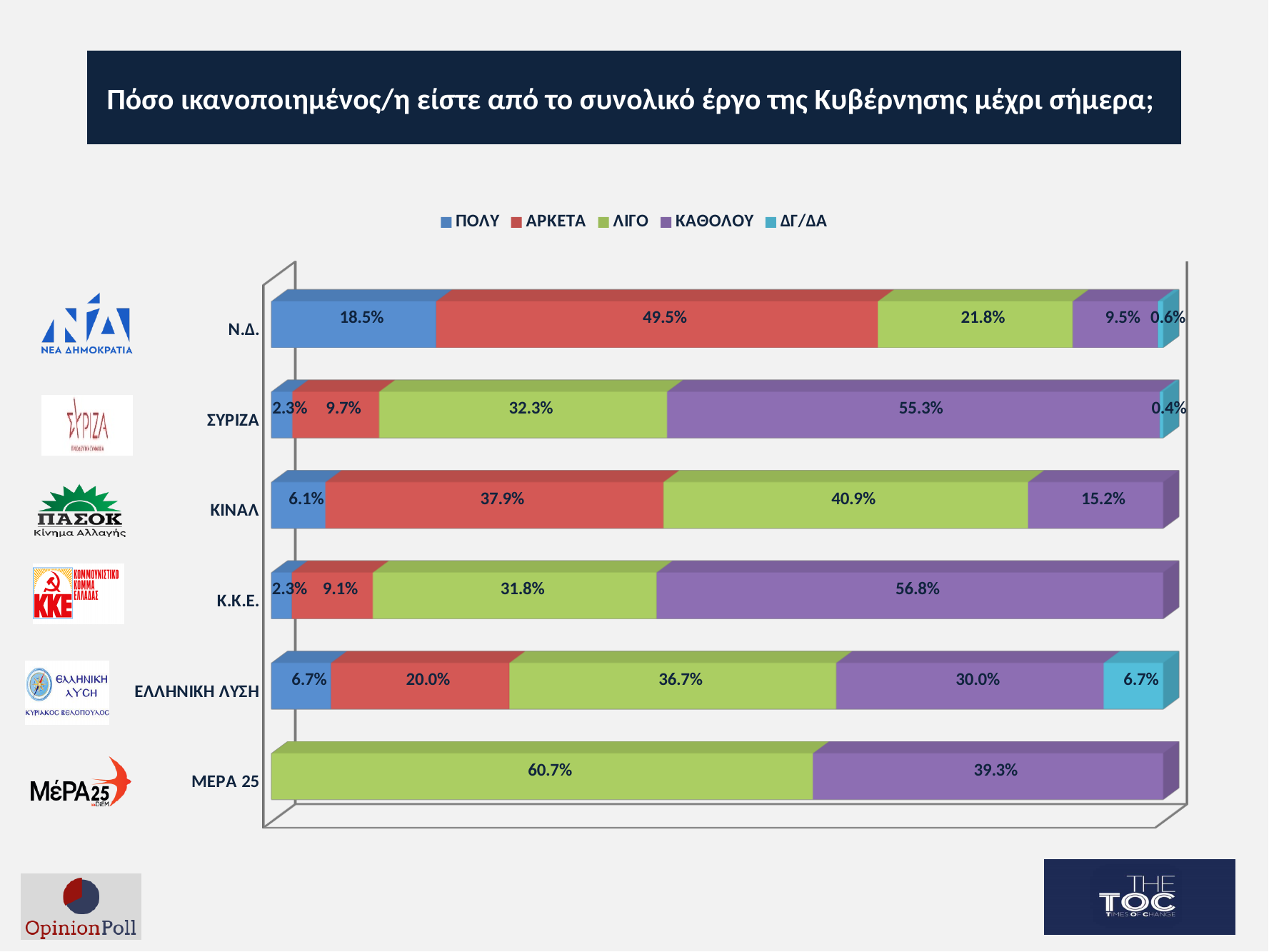
Which party has the highest ΚΑΘΟΛΟΥ value? Κ.Κ.Ε. What is the ΛΙΓΟ value for ΜΕΡΑ 25? 60.7% What is the total of the ΠΟΛΥ and ΑΡΚΕΤΑ values for Ν.Δ.? 68.0% Which is larger: the ΑΡΚΕΤΑ value for ΚΙΝΑΛ or the ΑΡΚΕΤΑ value for ΕΛΛΗΝΙΚΗ ΛΥΣΗ? ΚΙΝΑΛ How many parties (categories) are shown in the chart? 6 What is the ΑΡΚΕΤΑ value for Ν.Δ.? 49.5% What kind of chart is shown on the slide? Stacked bar chart What is the ΚΑΘΟΛΟΥ value for ΣΥΡΙΖΑ? 55.3% Which party has the highest ΠΟΛΥ value? Ν.Δ. What is the ΔΓ/ΔΑ value for ΕΛΛΗΝΙΚΗ ΛΥΣΗ? 6.7% What is the difference between the ΛΙΓΟ values for ΚΙΝΑΛ and Ν.Δ.? 19.1% How many series does the legend list? 5